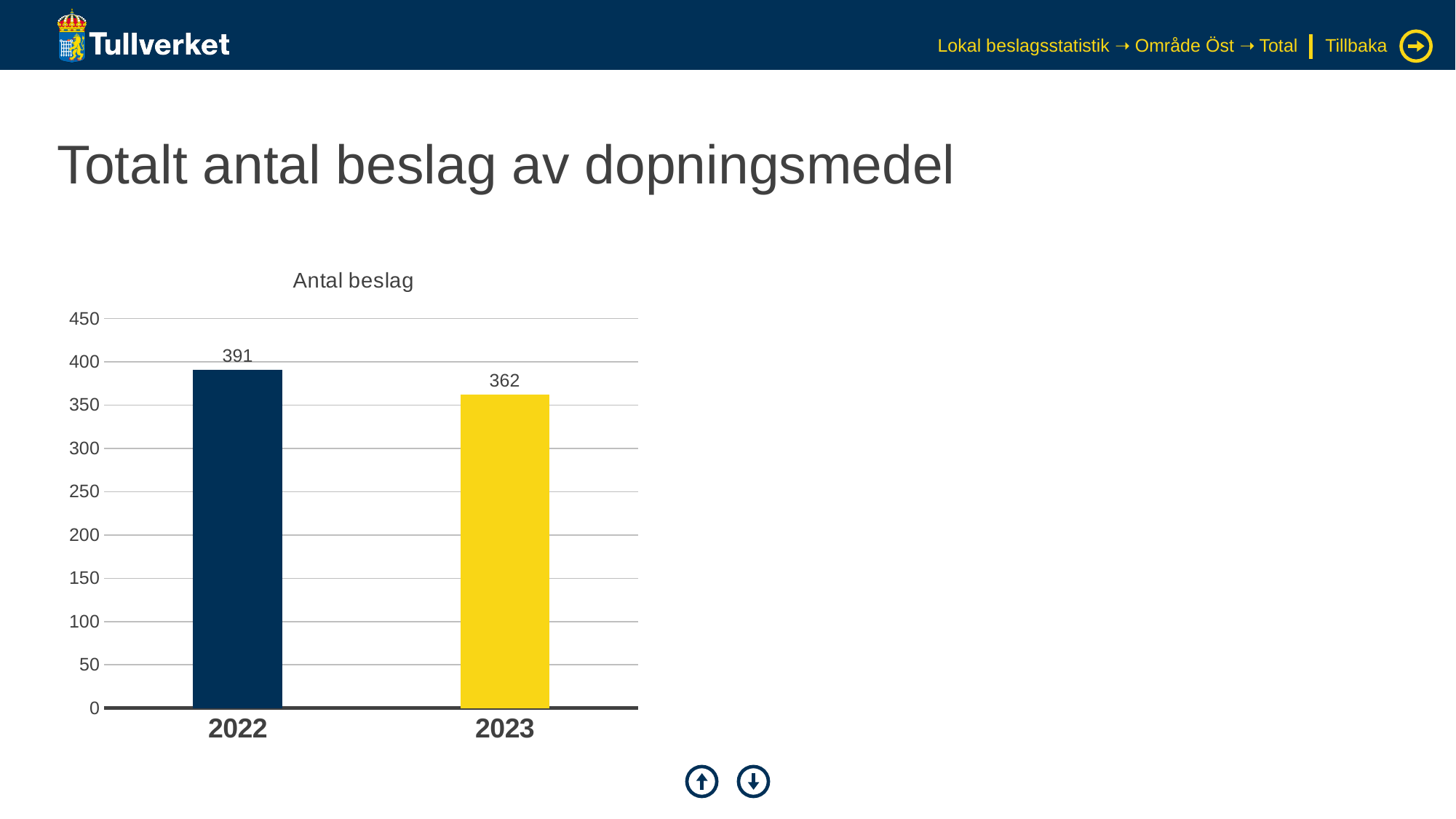
What kind of chart is shown on the slide? bar chart What is the title of the chart? Antal beslag What is the value for 2023? 362 Is the value for 2023 greater or less than 350? greater How many years are shown on the chart? 2 What is the value for 2022? 391 Which is larger, the value for 2022 or the value for 2023? 2022 Which year has the highest value? 2022 Which year has the lowest value? 2023 Do the values rise or fall from 2022 to 2023? fall Is the value for 2022 greater or less than 400? less What is the difference between the values for 2022 and 2023? 29